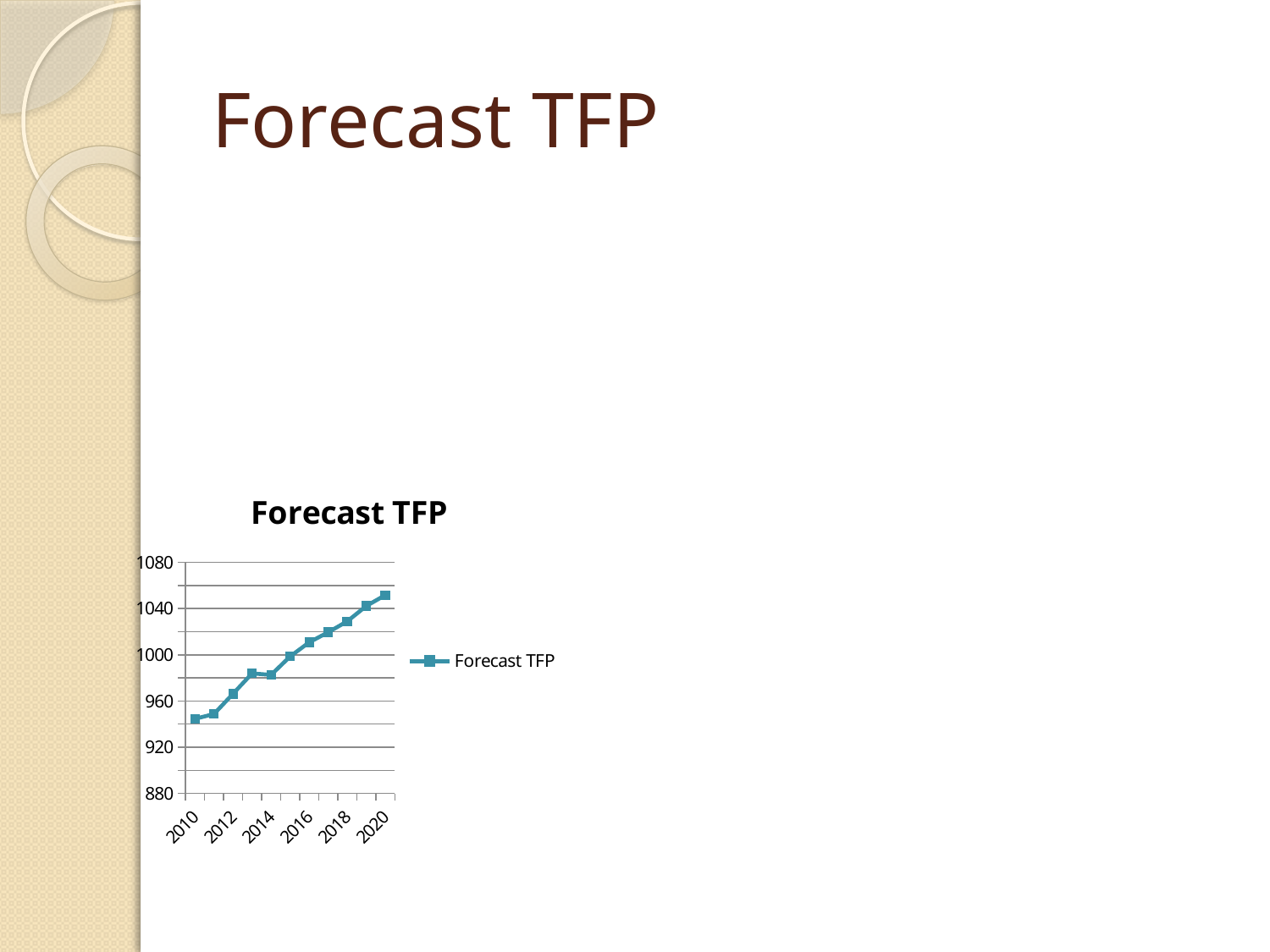
Which year has the larger Forecast TFP value, 2012 or 2018? 2018 What kind of chart is shown on the slide? line chart What is the name of the series shown in the legend? Forecast TFP How many data points are plotted on the line? 11 Do the Forecast TFP values rise or fall from 2010 to 2020? rise Is the Forecast TFP value for 2020 greater or less than 1040? greater Which year has the highest Forecast TFP value? 2020 How many series does the legend list? 1 What is the title of the chart? Forecast TFP Is the Forecast TFP value for 2010 greater or less than 960? less Which year has the lowest Forecast TFP value? 2010 Is the Forecast TFP value for 2018 greater or less than 1000? greater